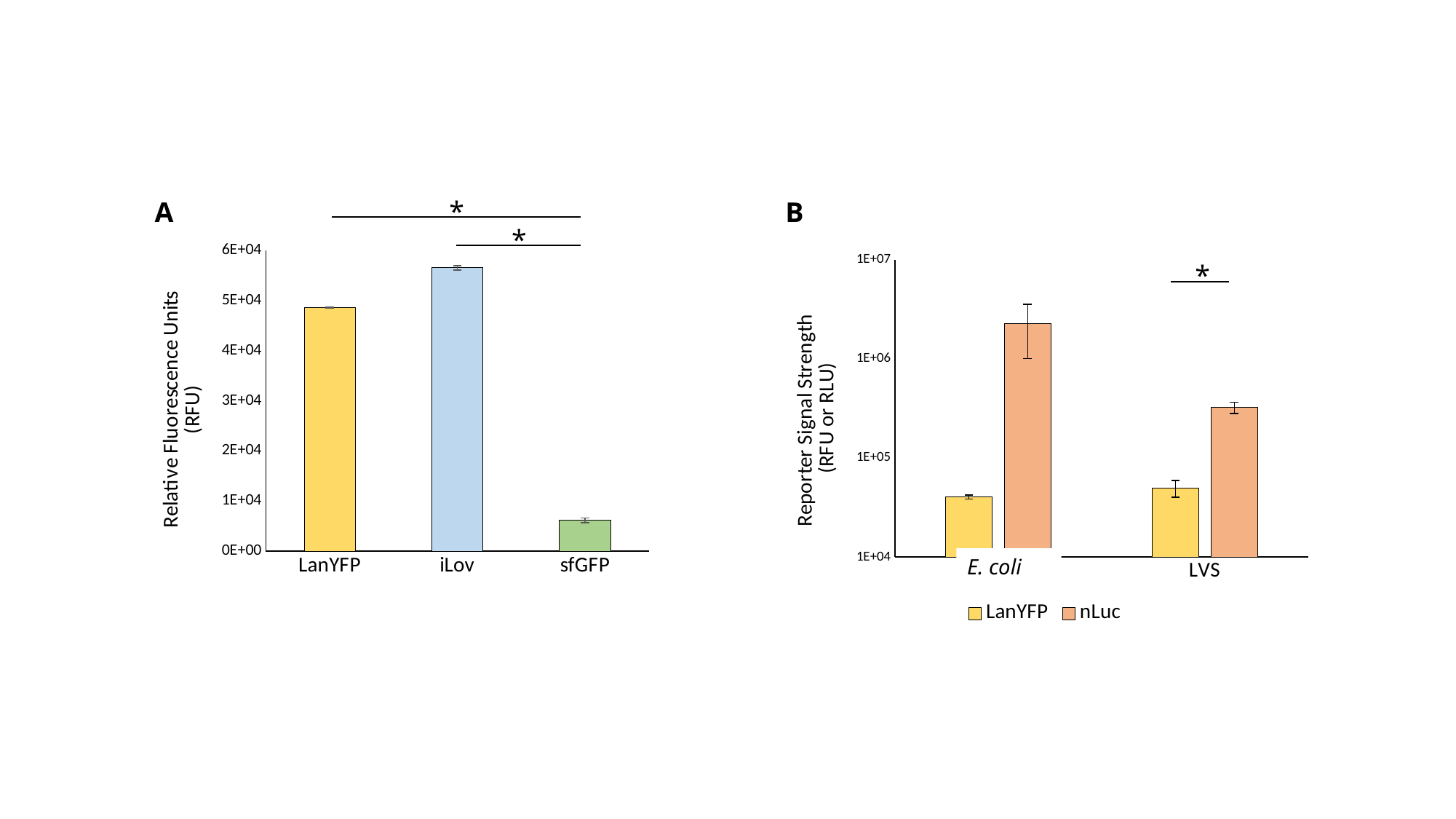
In chart B (right), what is the y-axis title? Reporter Signal Strength (RFU or RLU) In chart B (right), is the nLuc value for E. coli greater or less than 1E+06? greater In chart A (left), what kind of chart is shown? bar chart In chart A (left), which category has the lowest relative fluorescence? sfGFP In chart A (left), how many categories are plotted on the x axis? 3 In chart A (left), is the value for sfGFP greater or less than 1E+04? less In chart B (right), which is larger, the nLuc value for E. coli or the nLuc value for LVS? E. coli In chart A (left), is the value for LanYFP greater or less than 4E+04? greater In chart A (left), which is larger, the value for LanYFP or the value for iLov? iLov In chart A (left), which category has the highest relative fluorescence? iLov In chart B (right), how many categories are plotted on the x axis? 2 In chart B (right), how many series does the legend list? 2